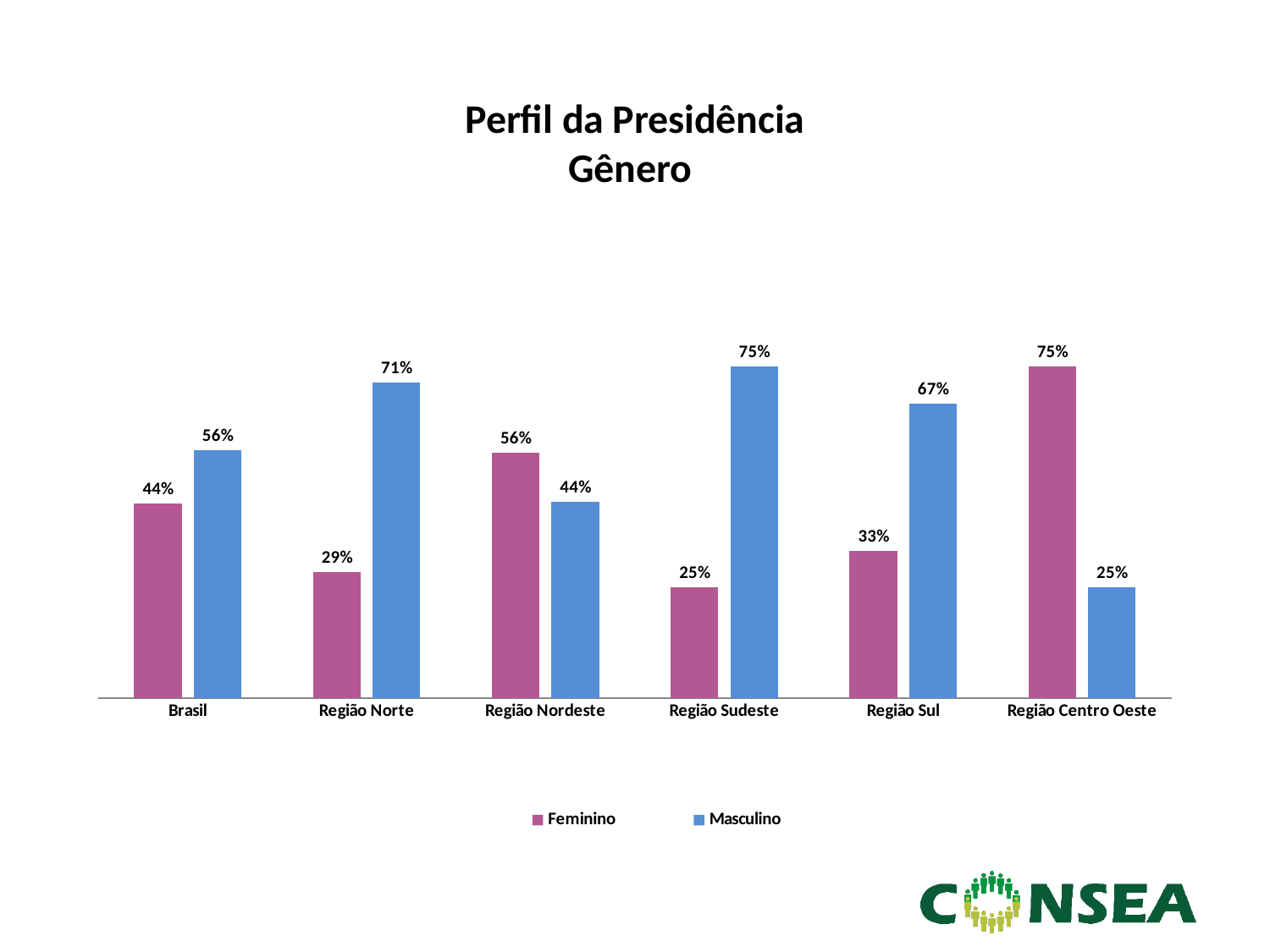
What is the Masculino value for Região Norte? 71% What colour represents the Masculino series? Blue Which category has the highest Feminino value? Região Centro Oeste How many categories are shown on the x axis? 6 How many series does the legend list? 2 Which category has the lowest Feminino value? Região Sudeste What is the Masculino value for Região Sul? 67% What is the difference between the Masculino and Feminino values for Região Sudeste? 50% Which is larger for Região Nordeste, the Feminino value or the Masculino value? Feminino What is the Feminino value for Brasil? 44% What kind of chart is shown on the slide? Bar chart What is the Feminino value for Região Centro Oeste? 75%